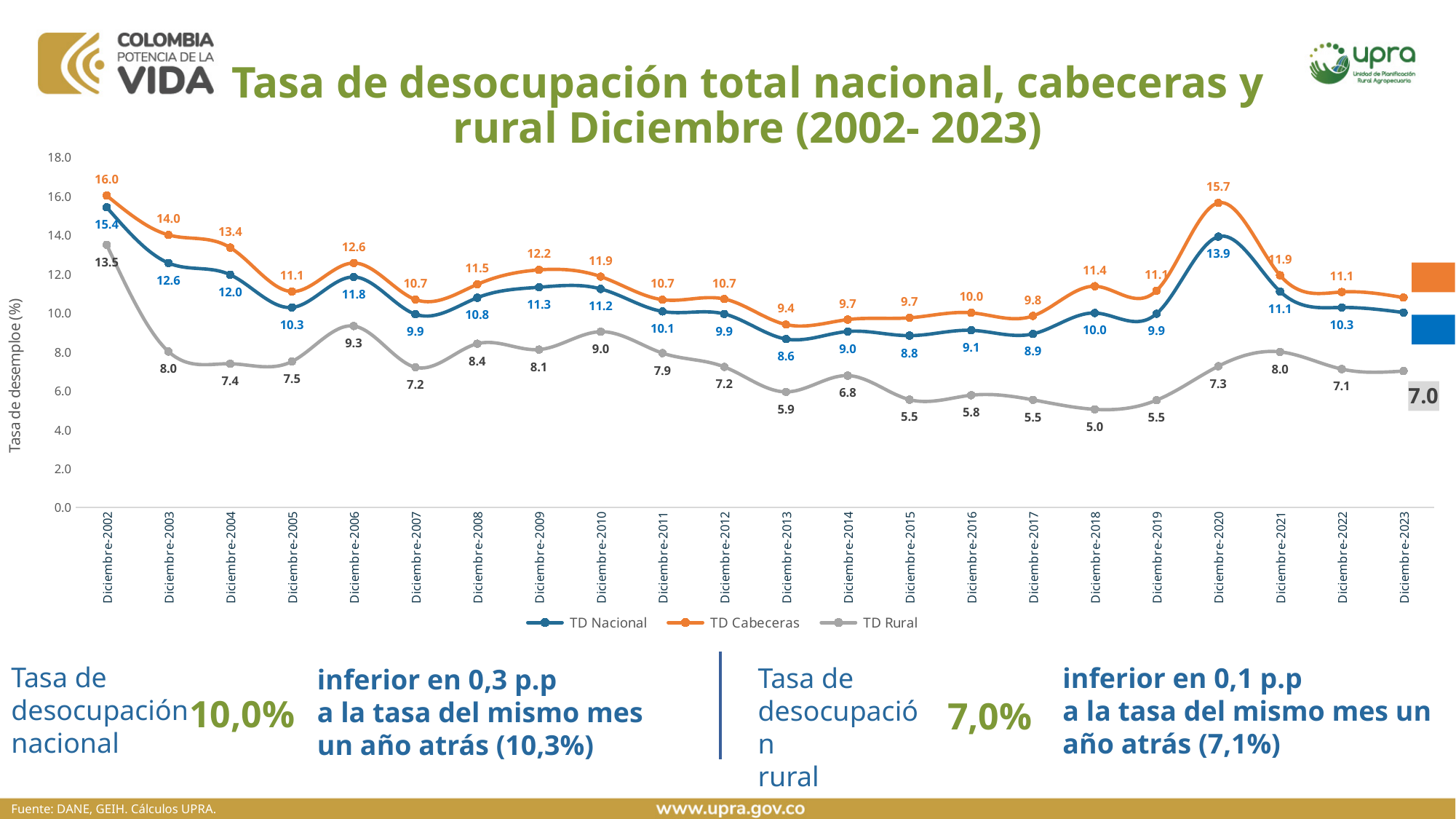
What is the value of TD Rural for Diciembre-2023? 7.0 What is the value of TD Rural for Diciembre-2018? 5.0 In which period does TD Cabeceras reach its highest value? Diciembre-2002 Which is larger for TD Nacional: Diciembre-2003 or Diciembre-2004? Diciembre-2003 In which period does TD Rural reach its lowest value? Diciembre-2018 What is the value of TD Cabeceras for Diciembre-2020? 15.7 How many series does the legend list? 3 Is the value of TD Cabeceras for Diciembre-2023 greater or less than 12.0? less What kind of chart is shown on the slide? Line chart What is the label of the y axis? Tasa de desempleo (%) How many time points are plotted on the x axis? 22 What is the difference between TD Nacional in Diciembre-2020 and Diciembre-2019? 4.0